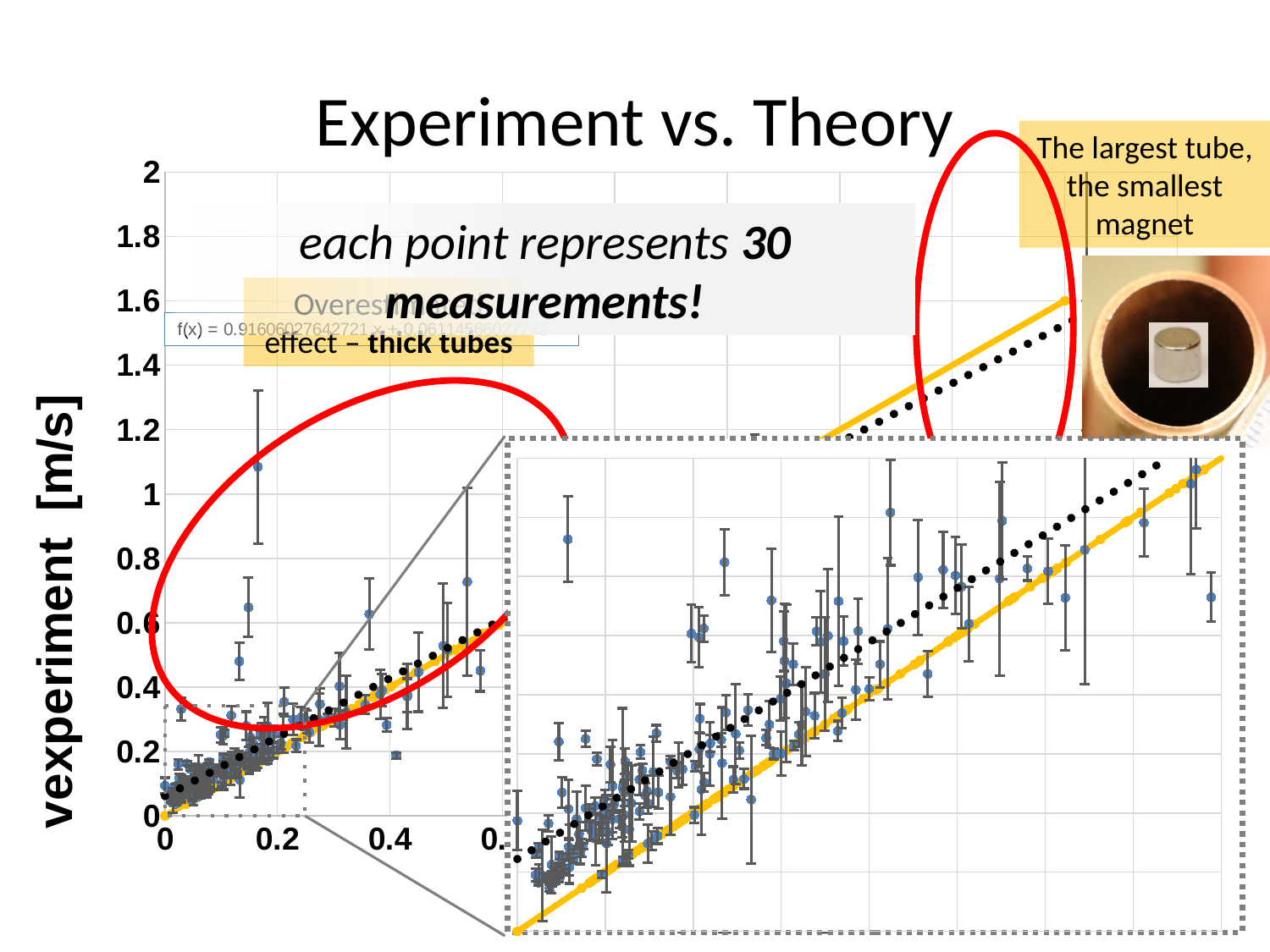
What is the title of the slide's chart? Experiment vs. Theory What is the spacing between consecutive tick marks on the vertical axis of the main chart? 0.2 What is the highest tick value shown on the vertical axis of the main chart? 2 Is the highest plotted point in the main chart (near x = 0.2) greater or less than 1 on the vertical axis? greater Is the plotted point near x = 0.4 with the tallest error bar greater or less than 0.8 on the vertical axis? less What is the label of the vertical axis of the main chart? vexperiment [m/s] Do the plotted values in the main chart generally rise or fall as the x value increases? rise What kind of chart is shown on the slide? scatter chart